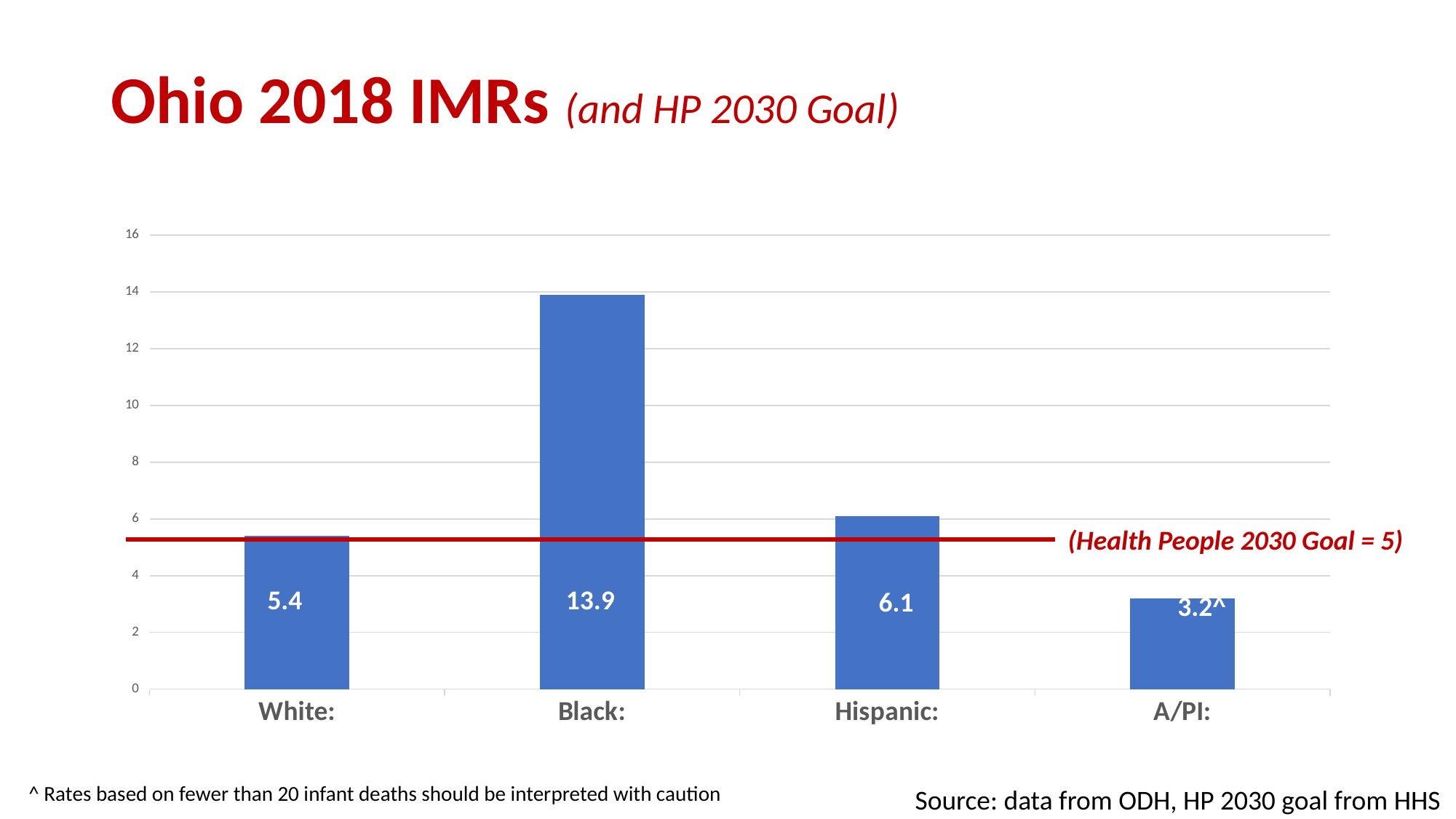
Which is larger, the Hispanic rate or the White rate? Hispanic What is the value shown for White? 5.4 What is the value shown for A/PI? 3.2^ Is the value for Black greater or less than 12? greater Which category has the highest infant mortality rate? Black What is the 2018 infant mortality rate shown for Black? 13.9 What is the difference between the Black and White rates? 8.5 Which category has the lowest infant mortality rate? A/PI What value does the red horizontal line on the chart represent? Health People 2030 Goal = 5 What is the value shown for Hispanic? 6.1 What kind of chart is shown on the slide? Bar chart How many categories are shown on the chart? 4